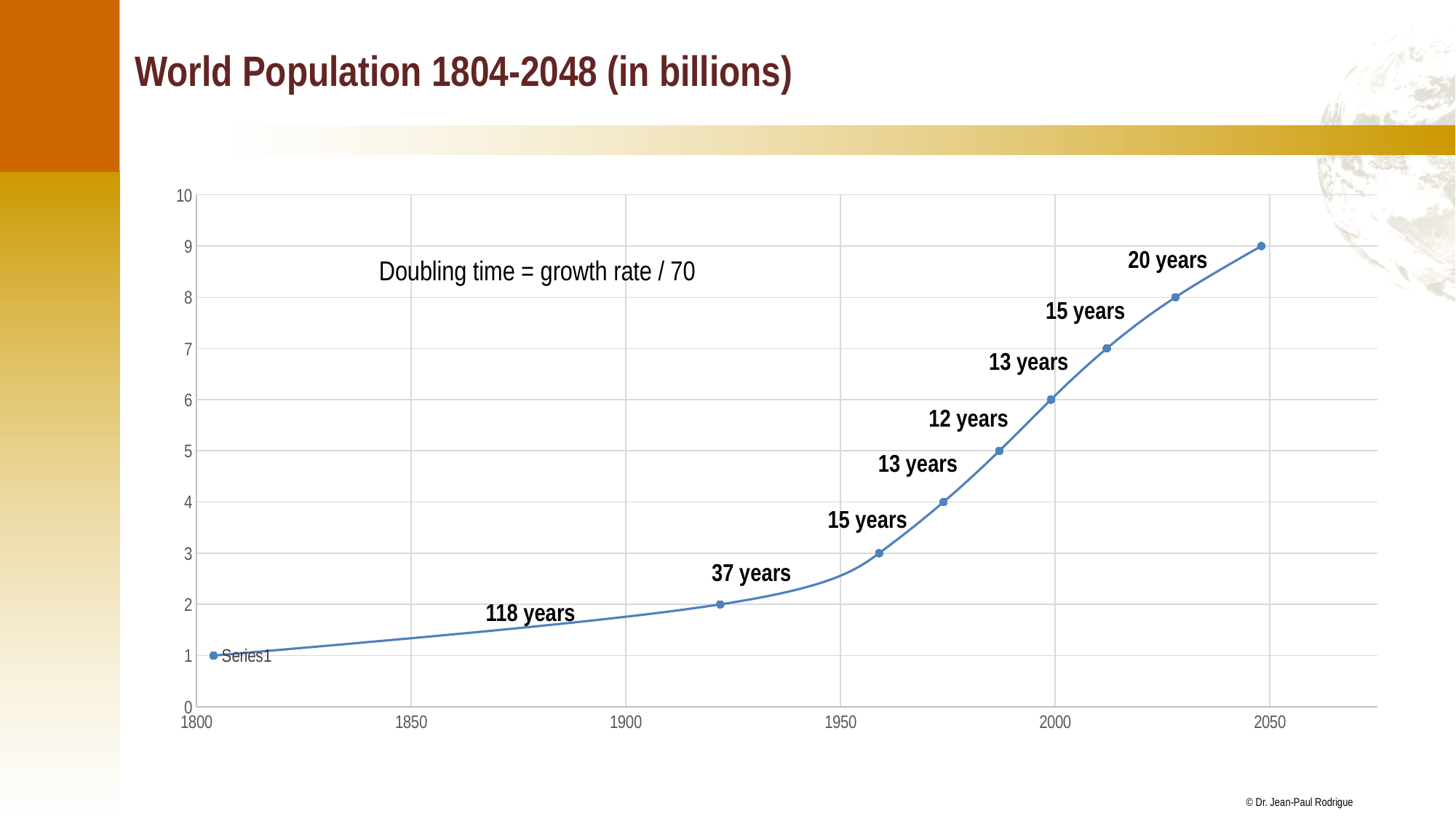
What is the difference between the highest and lowest plotted values? 8 What is the title of the chart? World Population 1804-2048 (in billions) Is the value of the line at 1900 greater or less than 2? less Do the values rise or fall as the years increase along the x axis? rise According to the label on the chart, how many years did it take for the population to go from 1 to 2 billion? 118 years Is the value of the line at 1850 greater or less than 1? greater What is the shortest doubling-interval label shown on the chart? 12 years Is the value of the line at 1950 greater or less than 2? greater How many data points are plotted on the line? 9 What is the value of the lowest plotted point on the chart? 1 What kind of chart is shown on the slide? line chart What is the value of the highest plotted point on the chart? 9